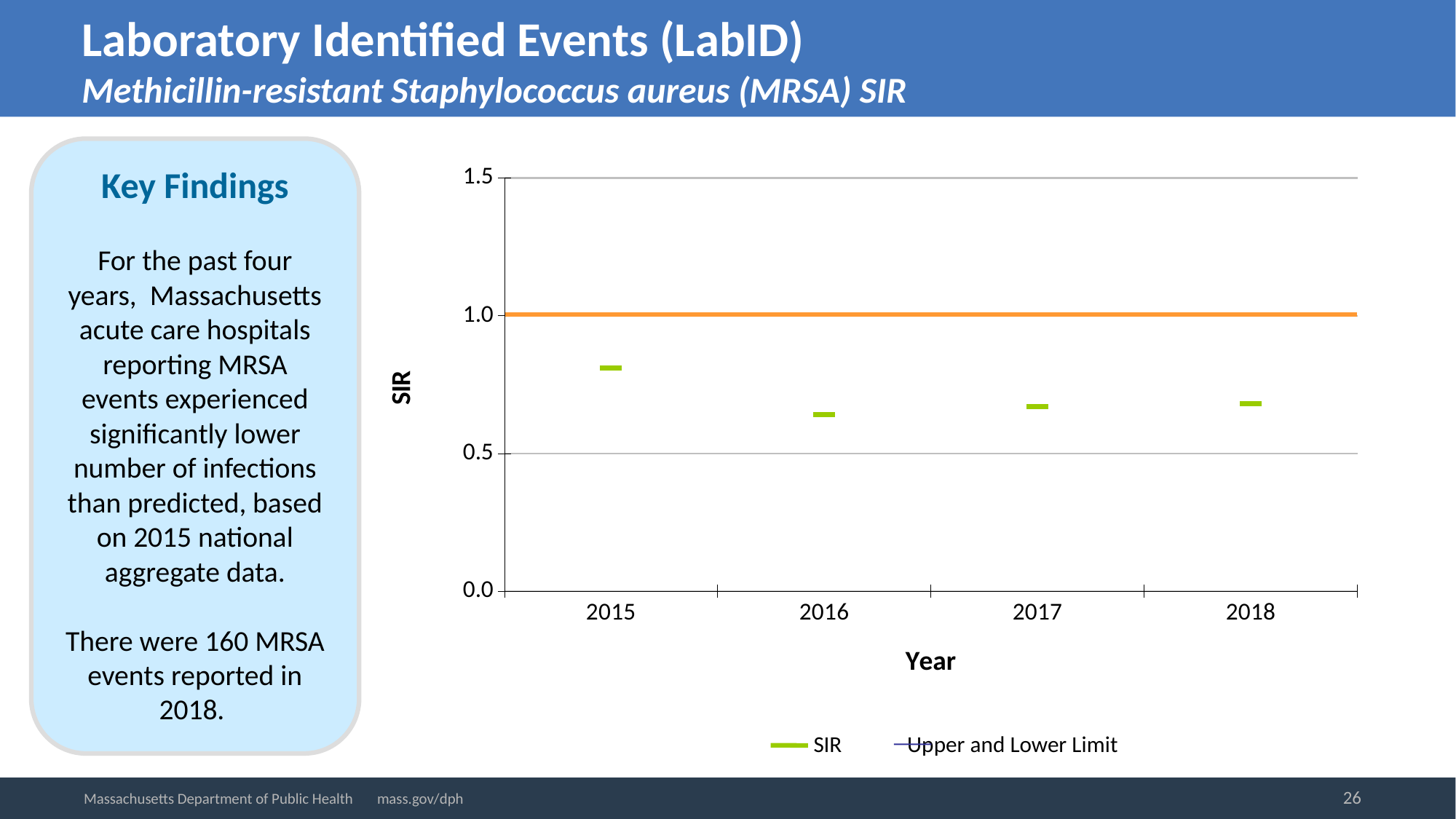
What colour is the Upper and Lower Limit line in the chart? orange Is the SIR value for 2015 greater or less than 0.5? greater Is the SIR value for 2016 greater or less than 1.0? less Is the SIR value for 2018 greater or less than 0.5? greater Does the SIR value rise or fall from 2015 to 2016? fall Which year has the highest SIR value in the chart? 2015 At what SIR value is the Upper and Lower Limit line drawn? 1.0 What is the label of the y axis of the chart? SIR How many years are shown on the x axis of the chart? 4 How many series does the chart legend list? 2 Which is larger, the SIR value for 2015 or for 2016? 2015